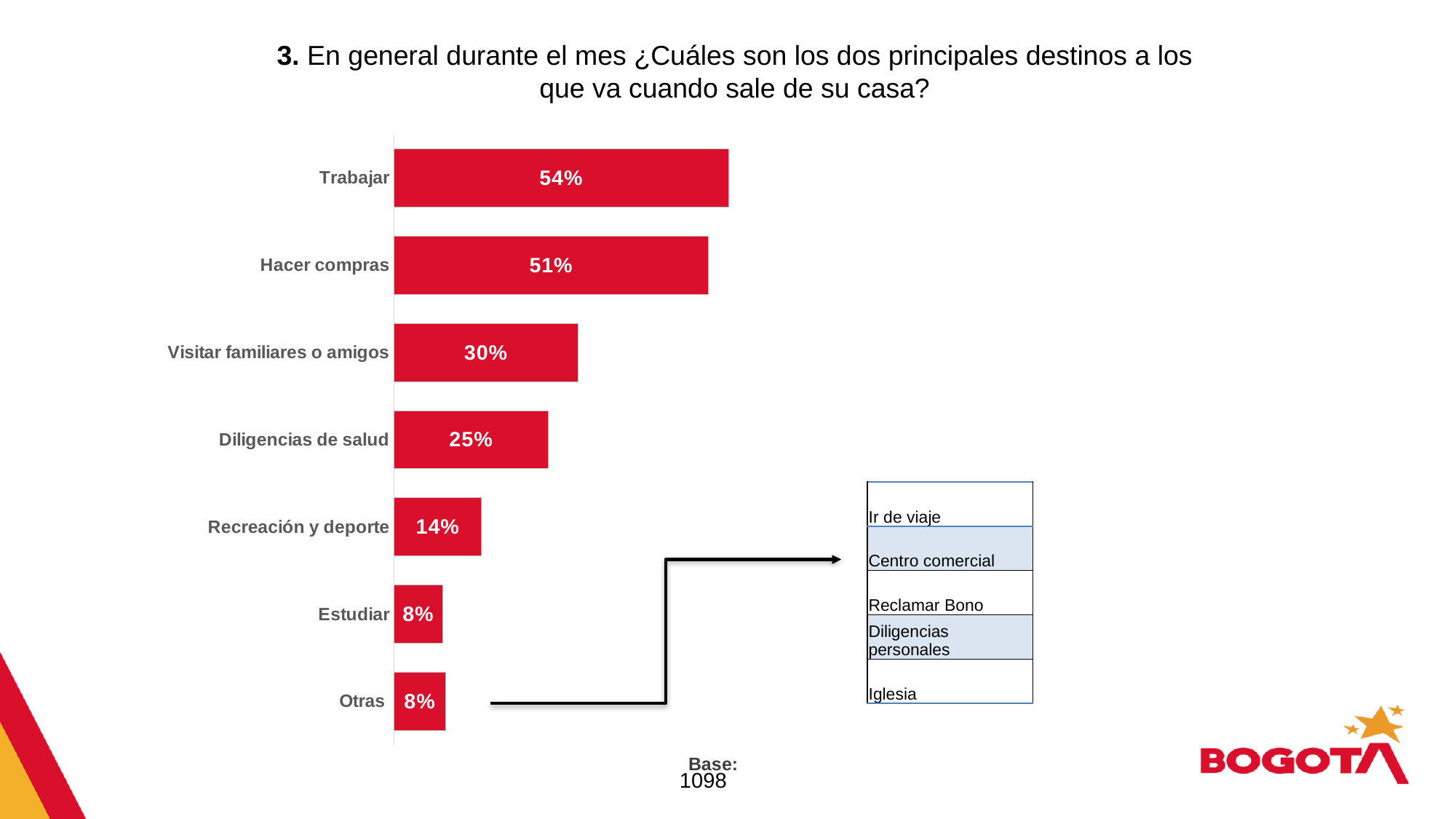
What percentage is shown for Diligencias de salud? 25% How many categories are shown in the chart? 7 What percentage is shown for Hacer compras? 51% What is the difference between the values for Trabajar and Hacer compras? 3% What kind of chart is shown on the slide? Bar chart What colour are the bars in the chart? Red Which category has the highest value? Trabajar Which is larger, the value for Visitar familiares o amigos or the value for Recreación y deporte? Visitar familiares o amigos What is the base (number of respondents) shown below the chart? 1098 What is the difference between the values for Visitar familiares o amigos and Diligencias de salud? 5% What percentage is shown for Trabajar? 54% What percentage is shown for Recreación y deporte? 14%